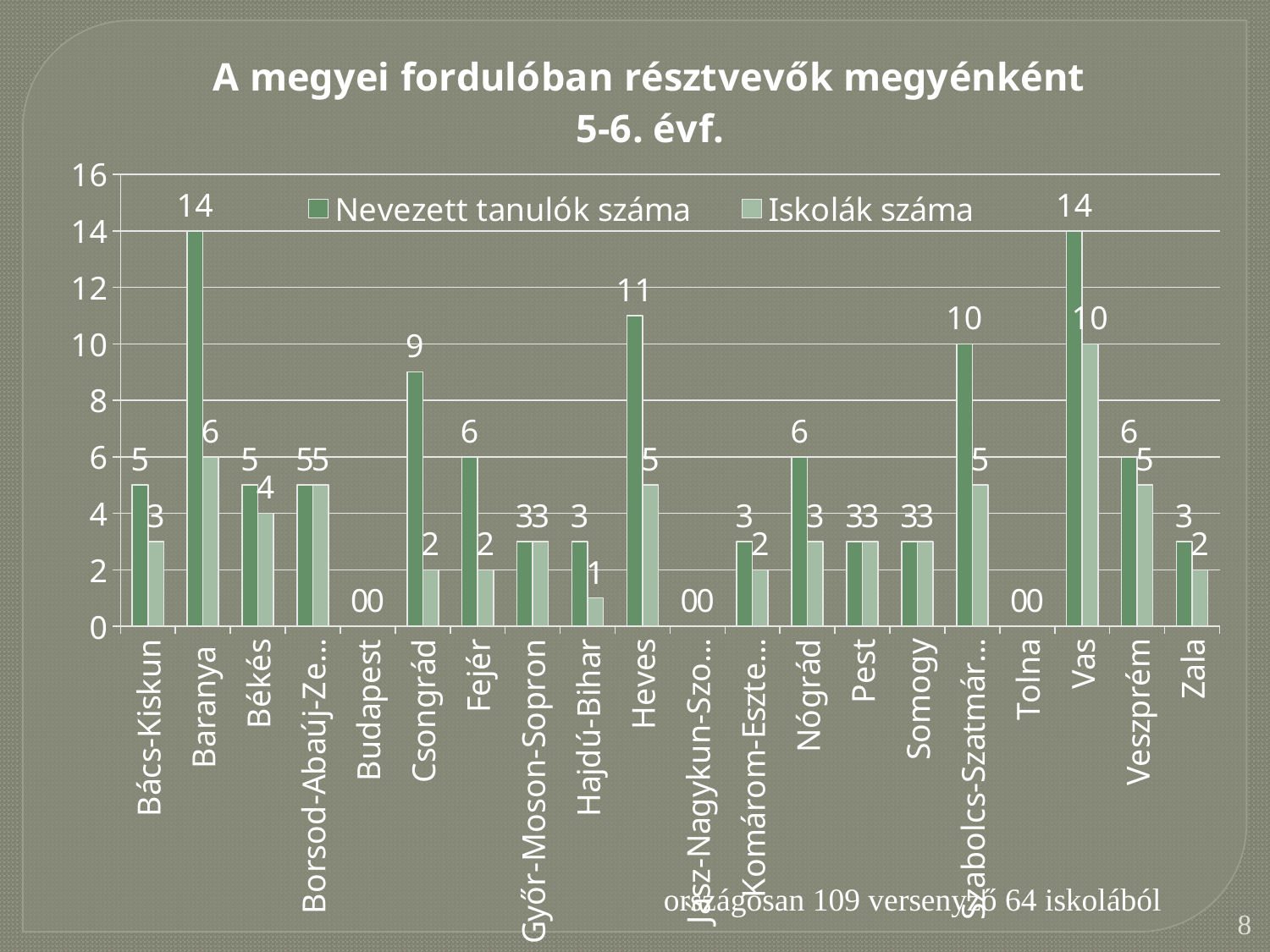
How many series does the legend list? 2 What is the title of the chart? A megyei fordulóban résztvevők megyénként 5-6. évf. What is the difference between Nevezett tanulók száma for Heves and for Nógrád? 5 What kind of chart is shown on the slide? Bar chart Which county has the highest value for Iskolák száma? Vas Which is larger, Nevezett tanulók száma for Csongrád or for Fejér? Csongrád What is the value of Nevezett tanulók száma for Csongrád? 9 What is the difference between Nevezett tanulók száma and Iskolák száma for Baranya? 8 How many counties are shown on the x axis? 20 What is the value of Iskolák száma for Vas? 10 What is the value of Nevezett tanulók száma for Heves? 11 What is the value of Iskolák száma for Hajdú-Bihar? 1